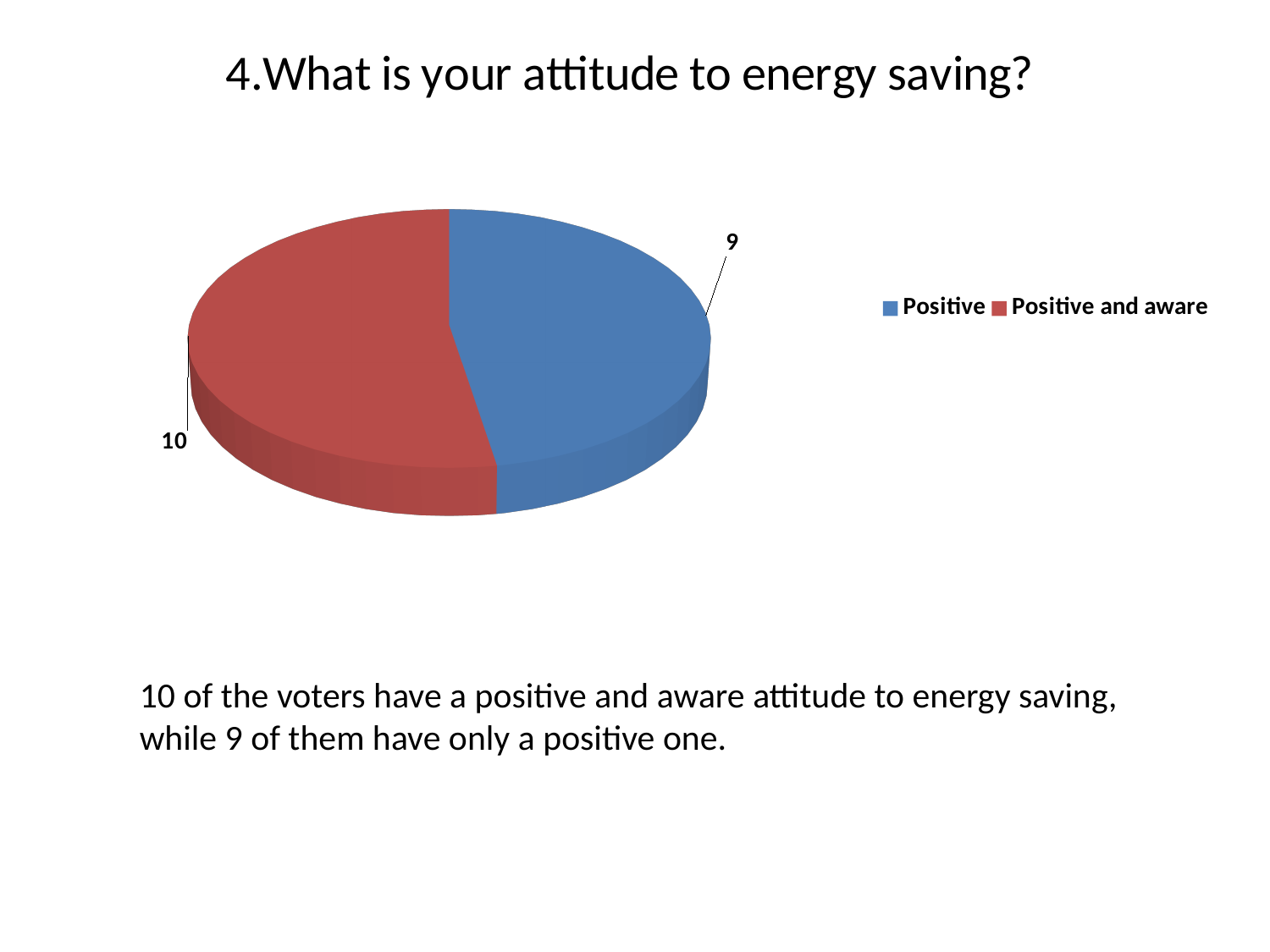
What kind of chart is shown on the slide? pie chart What is the difference between the Positive and aware value and the Positive value? 1 What is the value for the Positive slice? 9 Which category has the smallest slice of the pie? Positive Which category has the largest slice of the pie? Positive and aware How many entries does the legend list? 2 Which is larger, the value for Positive or the value for Positive and aware? Positive and aware What is the value for the Positive and aware slice? 10 What colour is the Positive and aware slice? red What is the total of all slices in the pie chart? 19 How many slices does the pie chart have? 2 What colour is the Positive slice? blue